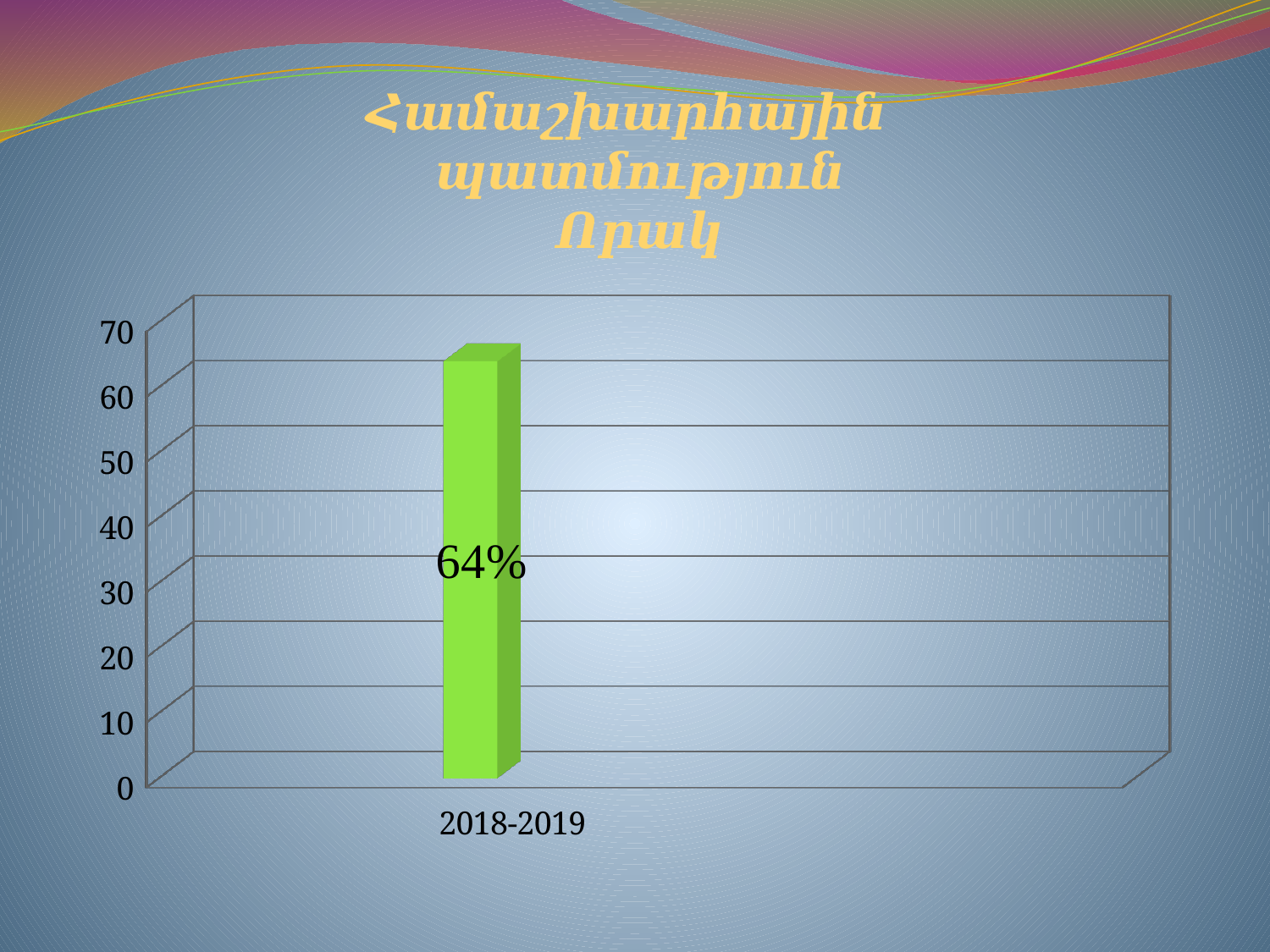
How many bars are plotted in the chart? 1 Is the value for 2018-2019 greater or less than 60? greater What colour is the bar in the chart? green What is the value shown for 2018-2019? 64% What kind of chart is shown on the slide? bar chart What is the highest value shown on the vertical axis? 70 What category label appears on the x axis? 2018-2019 Is the value for 2018-2019 greater or less than 70? less